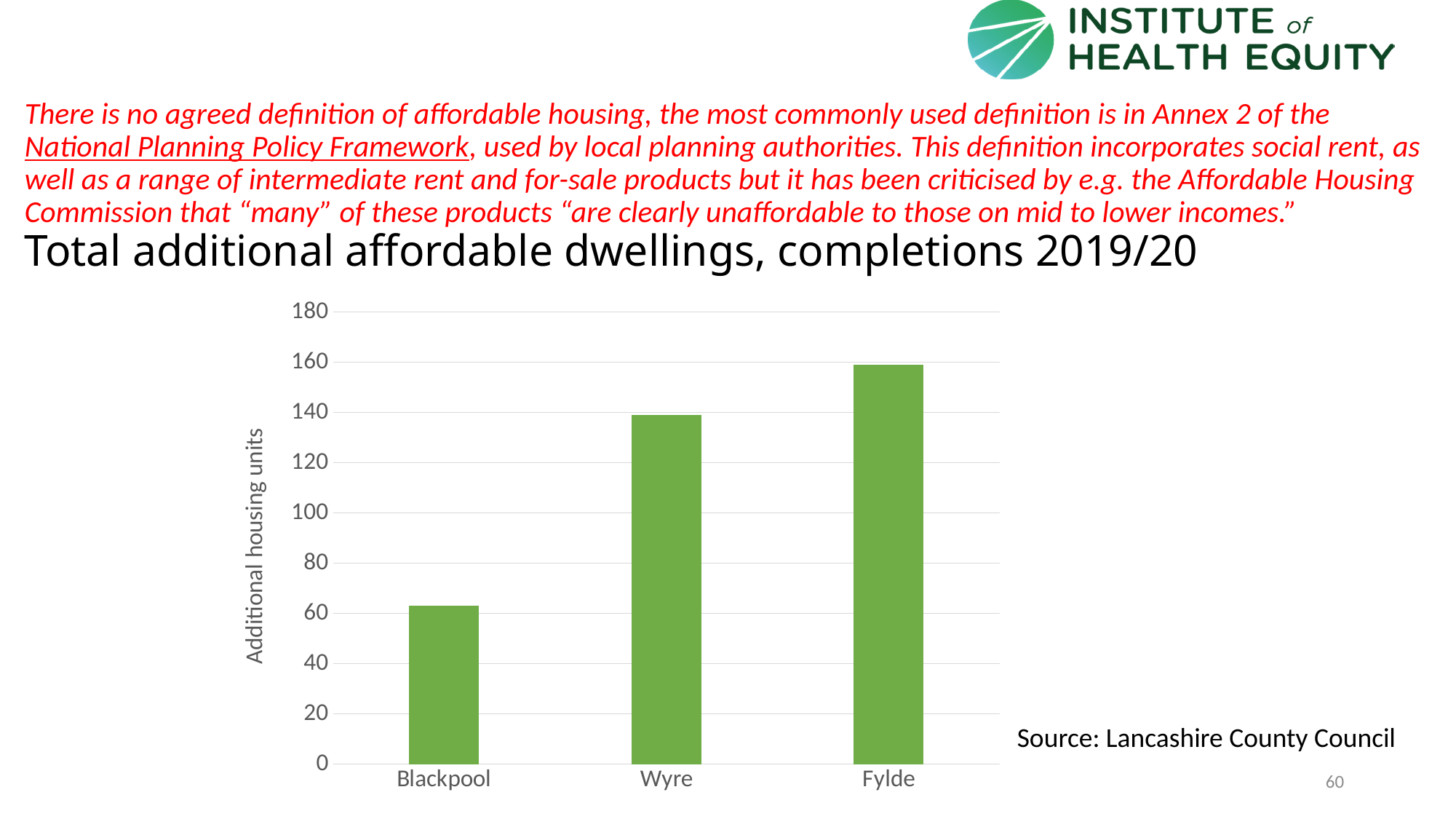
What is the title of the chart? Total additional affordable dwellings, completions 2019/20 Which has more additional affordable dwellings, Wyre or Fylde? Fylde What is the label on the y axis of the chart? Additional housing units How many categories are shown on the x axis of the chart? 3 Do the values rise or fall moving from Blackpool to Fylde along the x axis? rise What kind of chart is shown on the slide? bar chart Which area has the highest number of additional affordable dwellings? Fylde Which has more additional affordable dwellings, Blackpool or Wyre? Wyre Which area has the lowest number of additional affordable dwellings? Blackpool Is the value for Fylde greater or less than 140? greater Is the value for Blackpool greater or less than 80? less Is the value for Wyre greater or less than 120? greater